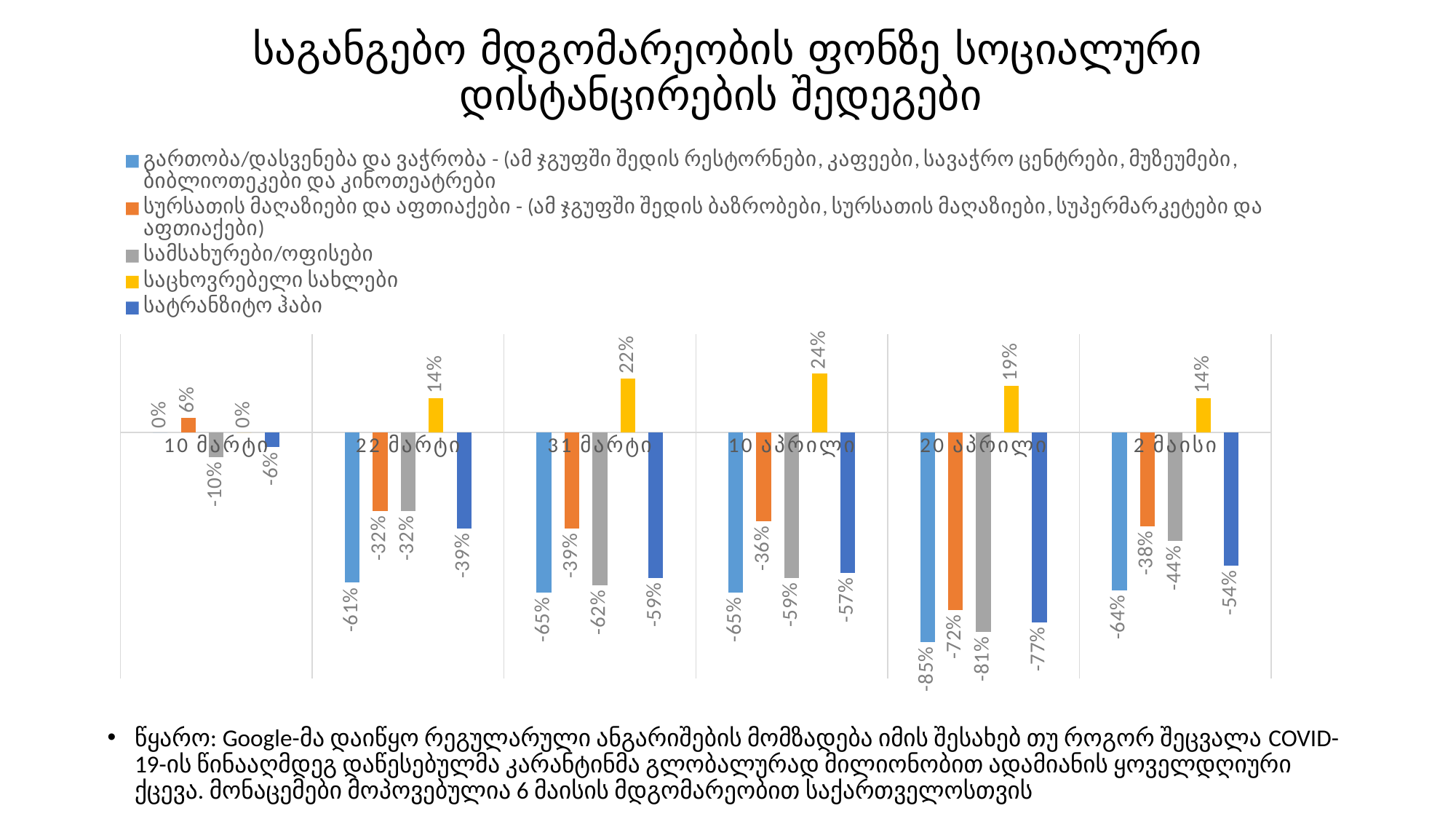
What is the value for სამსახურები/ოფისები on 2 მაისი? -44% On which date does საცხოვრებელი სახლები reach its highest value? 10 აპრილი On which date does გართობა/დასვენება და ვაჭრობა have its lowest value? 20 აპრილი What is the value for სატრანზიტო ჰაბი on 20 აპრილი? -77% What is the difference between the სამსახურები/ოფისები values on 20 აპრილი and 2 მაისი? 37 percentage points What type of chart is shown on the slide? bar chart How many date categories are shown on the x axis? 6 Which series is shown in yellow in the legend? საცხოვრებელი სახლები What is the value for სურსათის მაღაზიები და აფთიაქები on 10 მარტი? 6% What is the value for საცხოვრებელი სახლები on 10 აპრილი? 24% How many series does the legend list? 5 Which is larger on 31 მარტი: the value for სურსათის მაღაზიები და აფთიაქები or the value for სატრანზიტო ჰაბი? სურსათის მაღაზიები და აფთიაქები